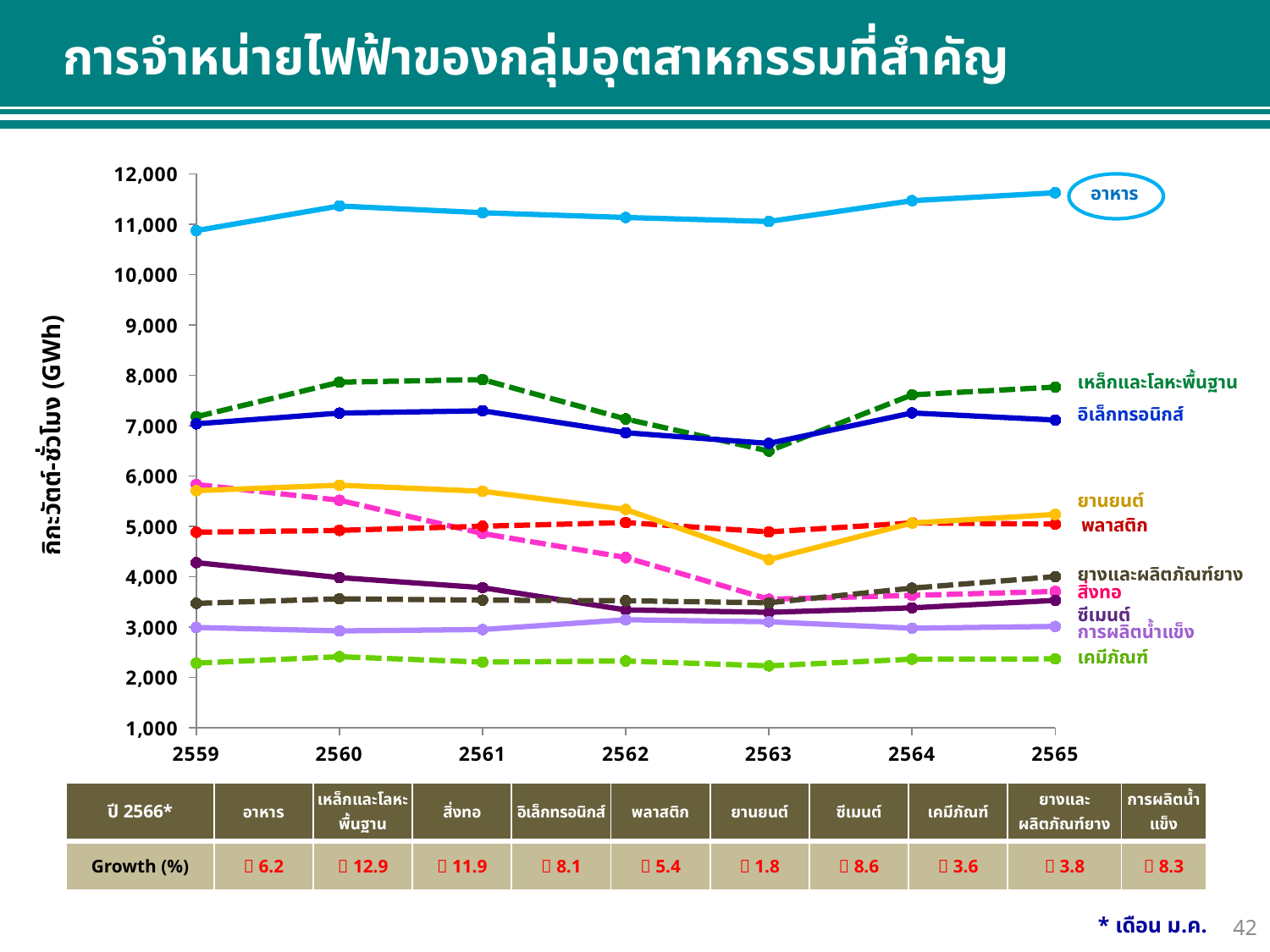
Is the value for เหล็กและโลหะพื้นฐาน in 2561 greater or less than 7,000? greater Does the สิ่งทอ series rise or fall from 2559 to 2563? fall How many industry series are labelled on the chart? 10 What kind of chart is shown on the slide? line chart Is the value for ยานยนต์ in 2563 greater or less than 5,000? less What is the label of the y axis of the chart? กิโลวัตต์-ชั่วโมง (GWh) Which industry series has the lowest electricity sales across all years shown? เคมีภัณฑ์ Is the value for เคมีภัณฑ์ in 2563 greater or less than 3,000? less Which industry series has the highest electricity sales across all years shown? อาหาร How many years are plotted along the x axis of the chart? 7 In 2559, which is larger: ยานยนต์ or พลาสติก? ยานยนต์